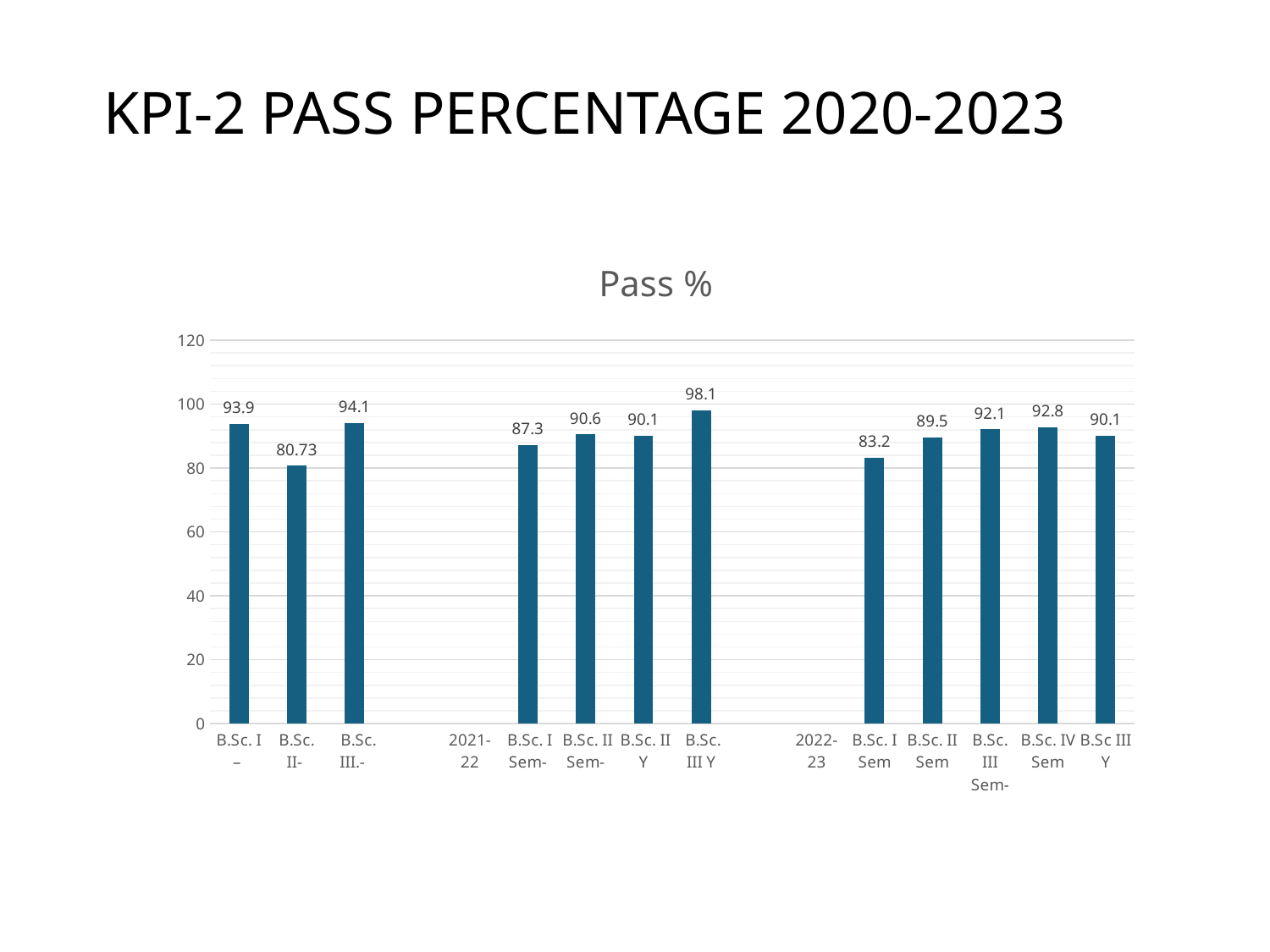
Is the value for B.Sc. II- greater or less than 100? less What is the pass percentage for B.Sc. IV Sem? 92.8 Which category has the lowest pass percentage in the chart? B.Sc. II- What is the difference between the highest value (98.1) and the lowest value (80.73) in the chart? 17.37 How many bars are plotted in the chart? 12 What is the title of the chart? Pass % Which has a higher pass percentage, B.Sc. IV Sem or B.Sc. III Sem-? B.Sc. IV Sem What is the pass percentage for B.Sc. III.-? 94.1 What is the difference between the values for B.Sc. III.- and B.Sc. I –? 0.2 What is the highest pass percentage value shown in the chart? 98.1 What is the pass percentage for the first bar, B.Sc. I –? 93.9 What kind of chart is shown on the slide? bar chart